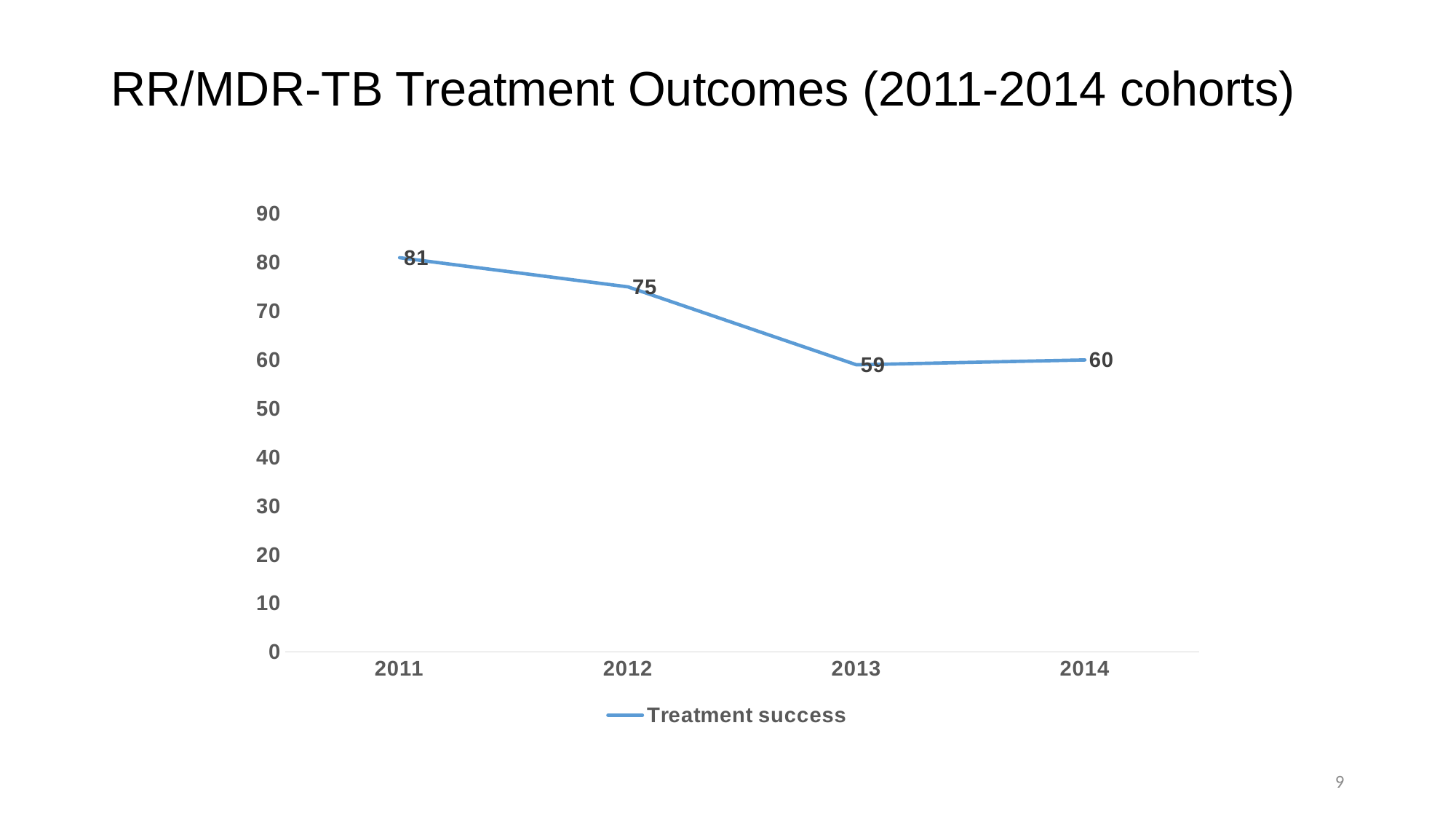
What is the treatment success value for 2014? 60 What kind of chart is shown on the slide? Line chart Which year has a larger treatment success value, 2012 or 2014? 2012 How many series does the legend list? 1 Which year has the highest treatment success value? 2011 What is the treatment success value for 2011? 81 What is the treatment success value for 2013? 59 What is the name of the series shown in the legend? Treatment success Which year has the lowest treatment success value? 2013 What is the difference between the treatment success values for 2011 and 2012? 6 How many years are plotted on the x axis? 4 What is the difference between the treatment success values for 2012 and 2013? 16